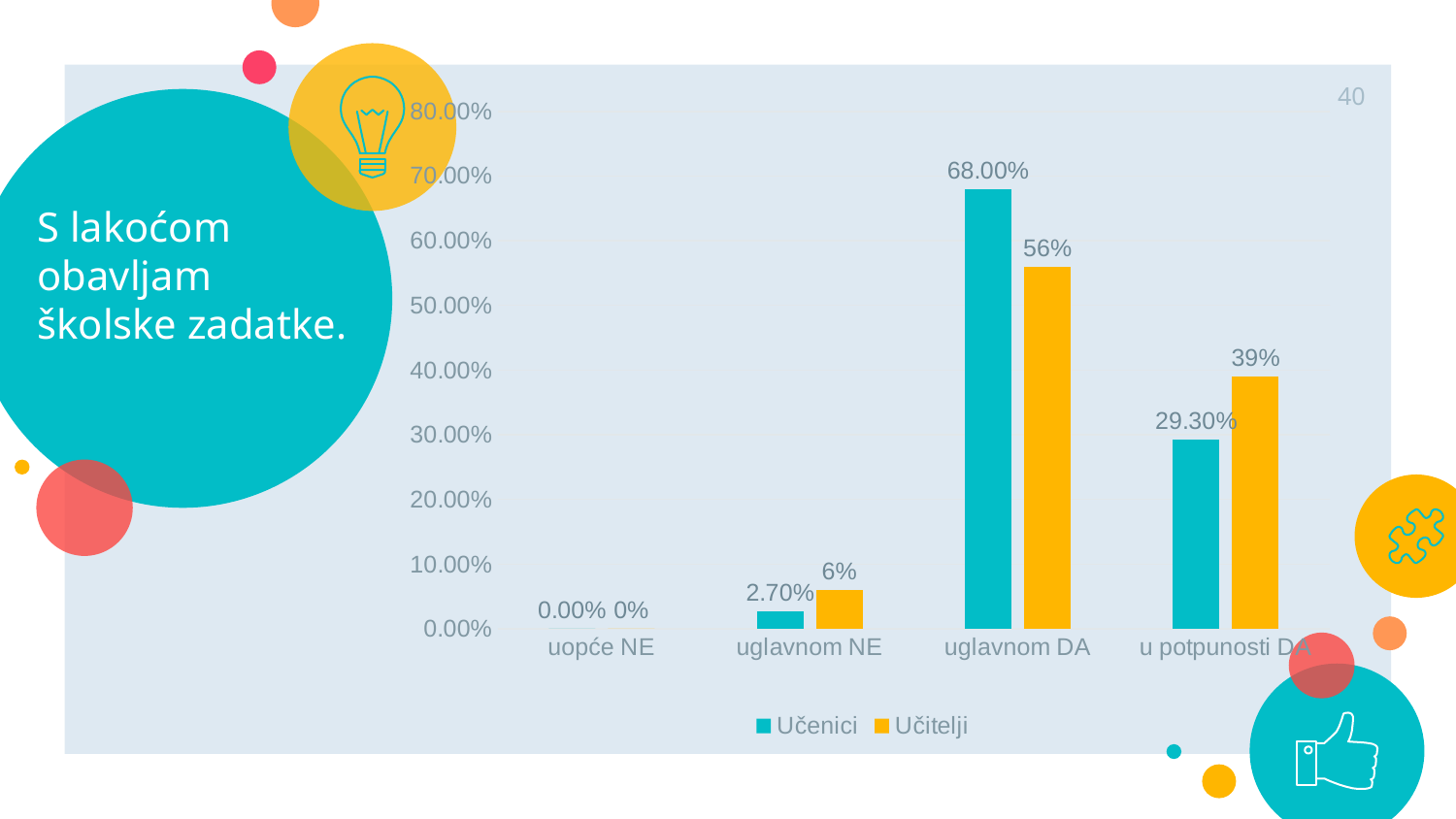
Which category has the lowest value for Učitelji? uopće NE What is the difference between the Učenici and Učitelji values in the 'uglavnom DA' category? 12 percentage points How many categories are shown on the x axis? 4 What is the value for Učenici in the 'uglavnom NE' category? 2.70% In the 'u potpunosti DA' category, which series has the larger value, Učenici or Učitelji? Učitelji Which category has the highest value for Učenici? uglavnom DA What is the statement shown as the title next to the chart? S lakoćom obavljam školske zadatke. What is the value for Učitelji in the 'uglavnom DA' category? 56% What type of chart is shown on the slide? bar chart What is the value for Učenici in the 'uglavnom DA' category? 68.00% What is the value for Učitelji in the 'u potpunosti DA' category? 39% How many series does the legend list? 2